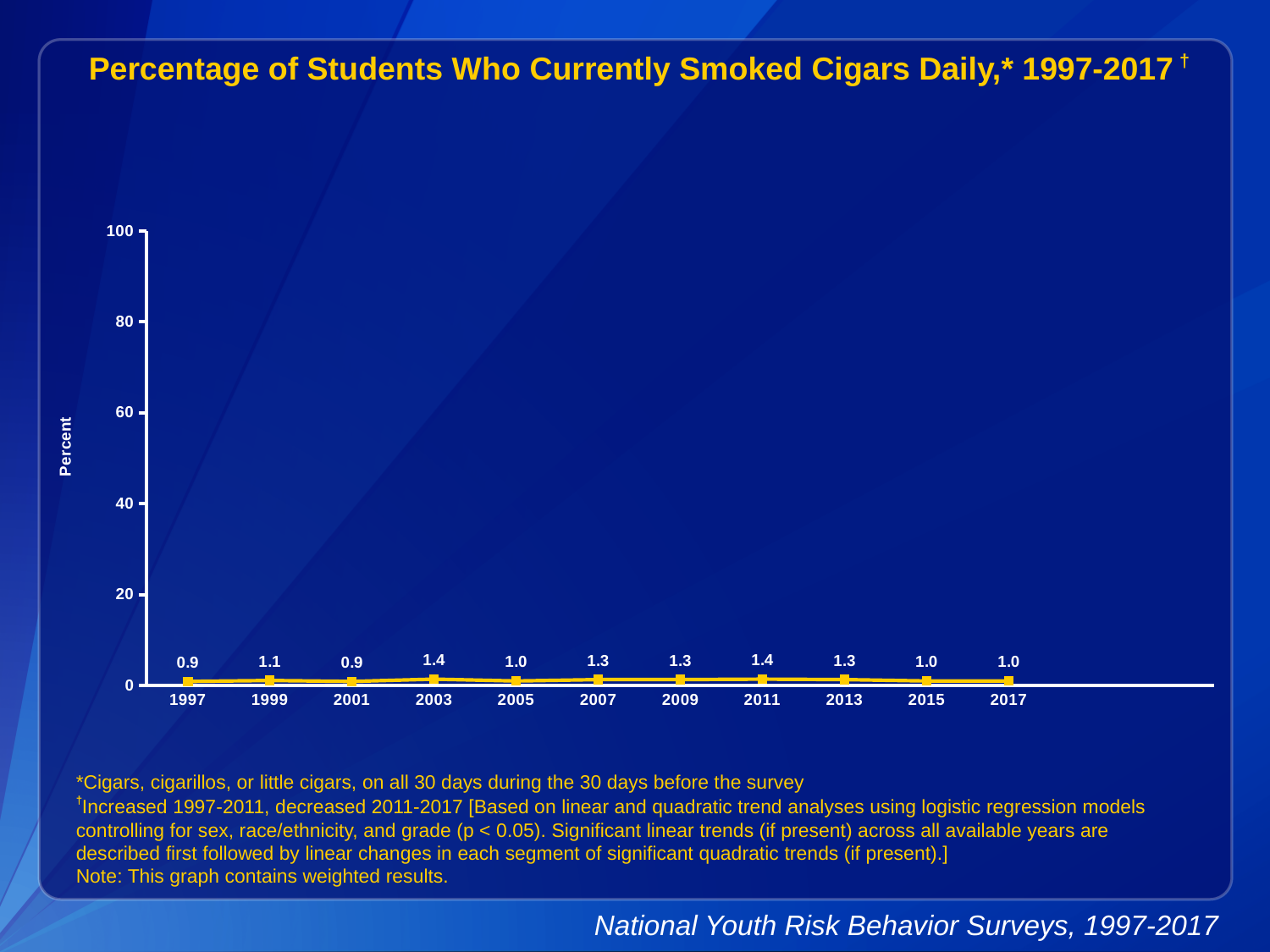
What is the lowest value plotted on the chart? 0.9 What was the percentage of students who currently smoked cigars daily in 2017? 1.0 What is the highest value plotted on the chart? 1.4 What is the label on the vertical axis? Percent What is the difference between the values for 2003 and 1997? 0.5 What was the percentage of students who currently smoked cigars daily in 1997? 0.9 Is the value for 2009 greater or less than 20? less How many years are plotted on the chart? 11 Do the values rise or fall from 2011 to 2017? fall Which year has the larger value, 2003 or 2005? 2003 What was the percentage of students who currently smoked cigars daily in 2011? 1.4 What type of chart is shown on the slide? line chart